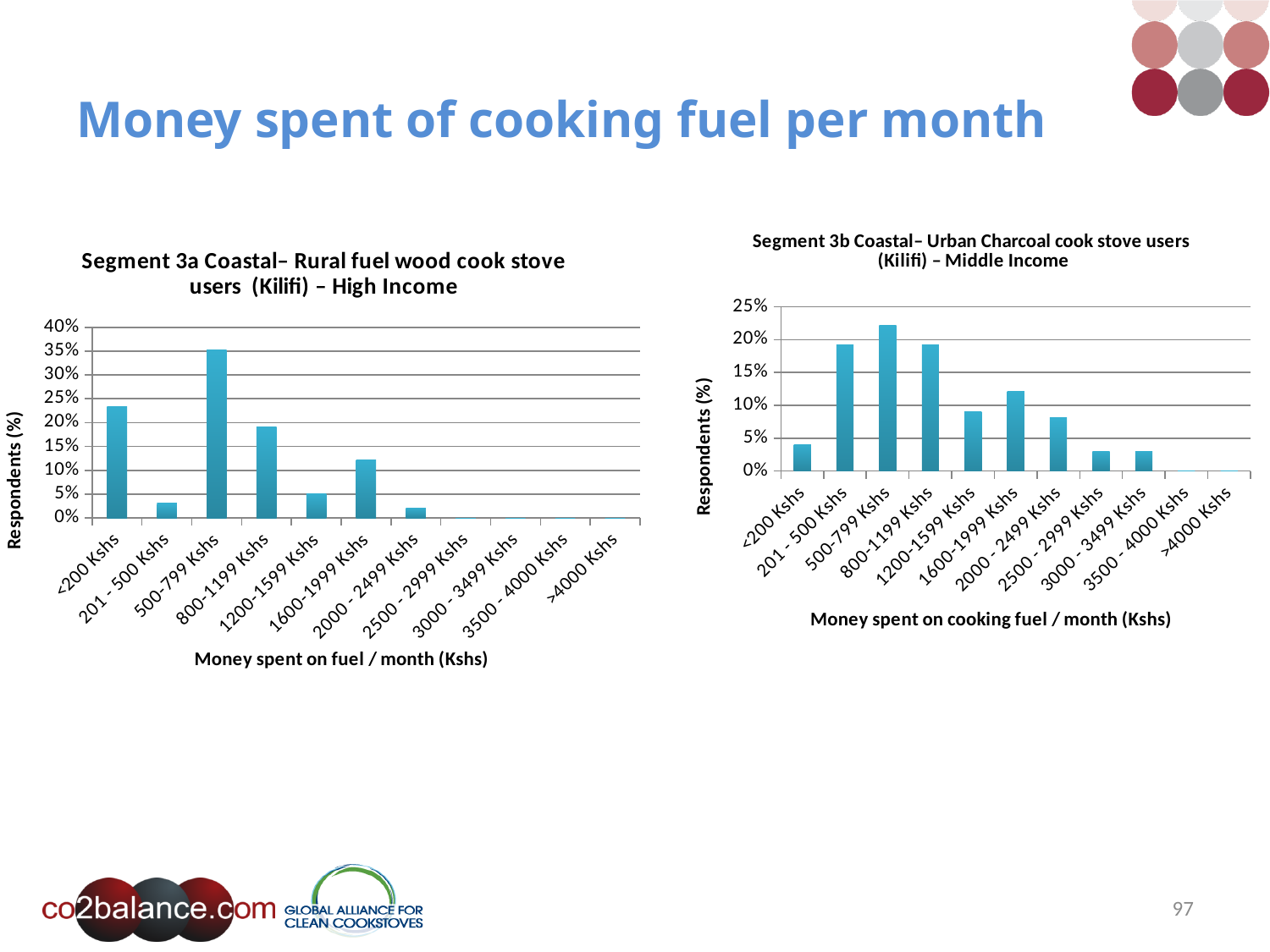
In the Segment 3a Coastal chart on the left, is the value for 201 - 500 Kshs greater or less than 5%? less In the Segment 3b Coastal chart on the right, is the value for 500-799 Kshs greater or less than 20%? greater What is the highest value shown on the y axis of the Segment 3a Coastal chart on the left? 40% In the Segment 3a Coastal chart on the left, which spending category has the highest share of respondents? 500-799 Kshs What is the x-axis label of the Segment 3b Coastal chart on the right? Money spent on cooking fuel / month (Kshs) In the Segment 3b Coastal chart on the right, which spending category has the highest share of respondents? 500-799 Kshs What kind of chart is the Segment 3b Coastal chart on the right? Bar chart In the Segment 3b Coastal chart on the right, which is larger: the value for 1600-1999 Kshs or the value for 1200-1599 Kshs? 1600-1999 Kshs In the Segment 3b Coastal chart on the right, is the value for <200 Kshs greater or less than 5%? less In the Segment 3a Coastal chart on the left, which is larger: the value for <200 Kshs or the value for 800-1199 Kshs? <200 Kshs How many spending categories are shown on the x axis of the Segment 3a Coastal chart on the left? 11